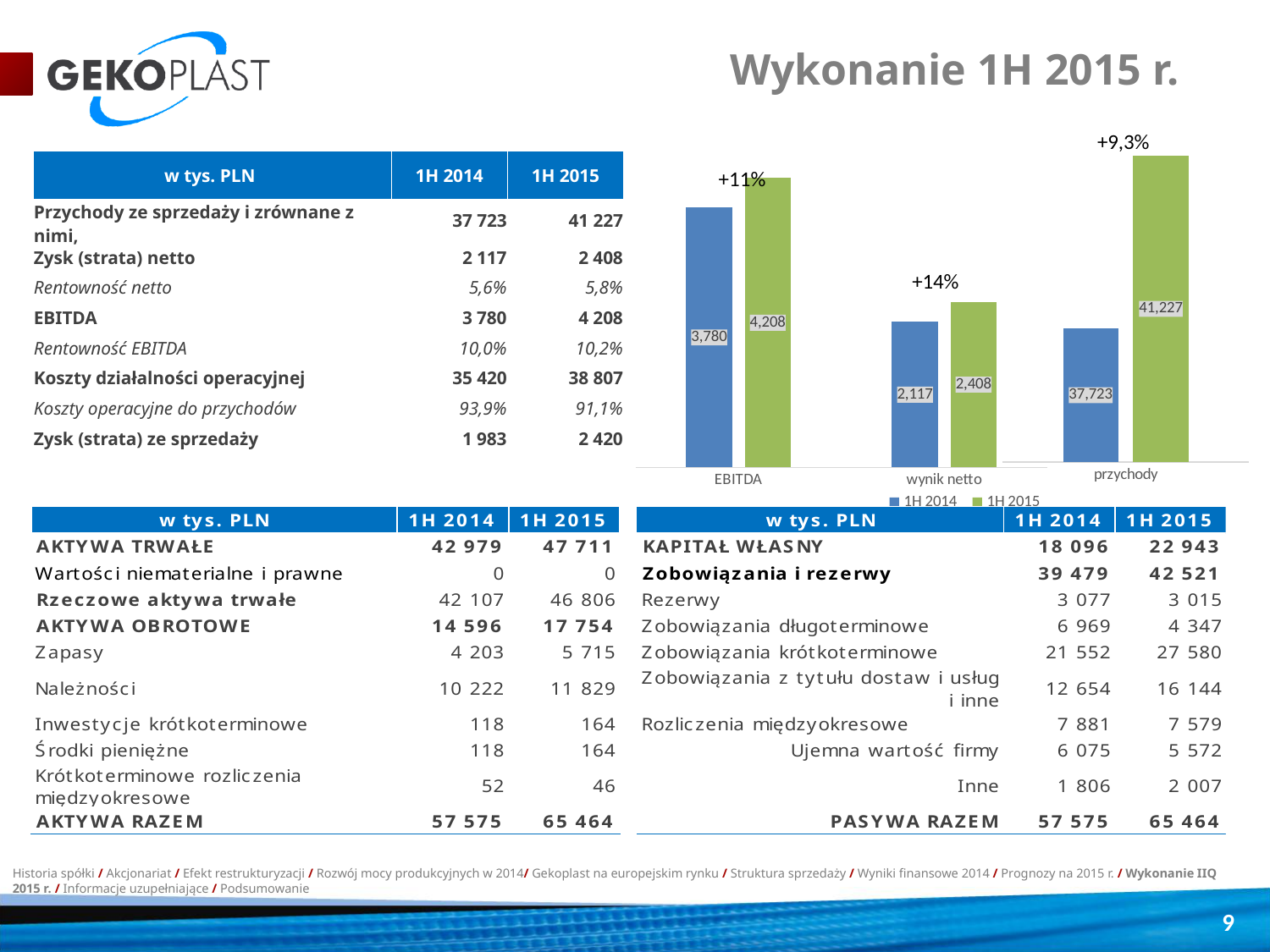
What is the difference between the 1H 2015 and 1H 2014 przychody values in the chart? 3,504 How many series does the chart legend list? 2 What is the difference between the 1H 2015 and 1H 2014 EBITDA values in the chart? 428 What type of chart is shown on the slide? bar chart What is the EBITDA value for 1H 2015 in the chart? 4,208 What is the wynik netto value for 1H 2015 in the chart? 2,408 What percentage change is labelled above the przychody bars in the chart? +9,3% What is the EBITDA value for 1H 2014 in the chart? 3,780 For wynik netto, which series has the larger value, 1H 2014 or 1H 2015? 1H 2015 What percentage change is labelled above the wynik netto bars in the chart? +14% What is the przychody value for 1H 2014 in the chart? 37,723